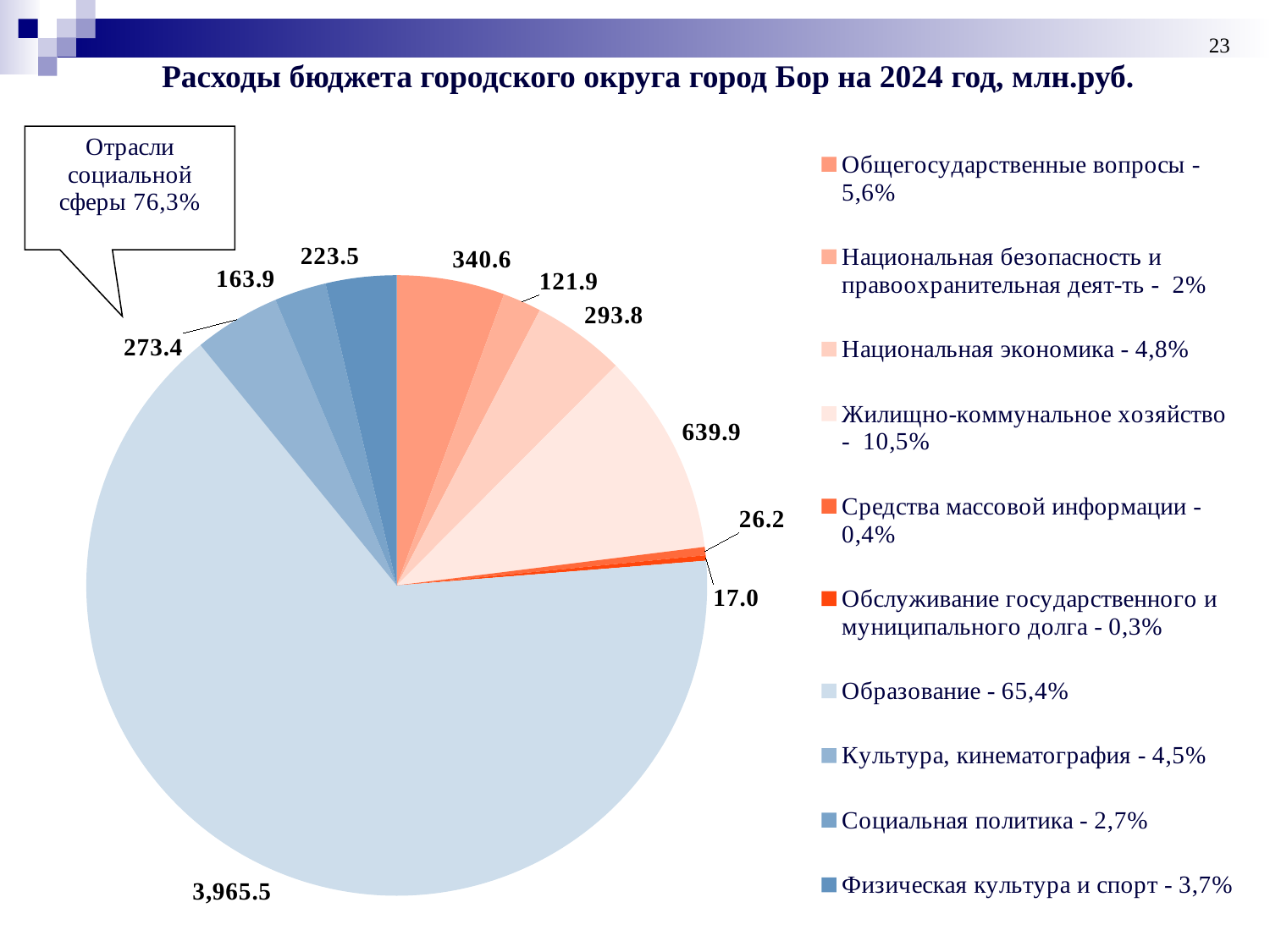
What is the value of the Жилищно-коммунальное хозяйство slice? 639.9 What is the value of the Общегосударственные вопросы slice? 340.6 What is the difference between the Культура, кинематография slice (273.4) and the Социальная политика slice (163.9)? 109.5 What type of chart is shown on the slide? pie chart Which category has the largest slice of the pie? Образование How many slices does the pie chart have? 10 Which category has the smallest slice of the pie? Обслуживание государственного и муниципального долга What share of the pie does Образование represent according to the legend? 65,4% Which is larger: the Физическая культура и спорт slice or the Национальная безопасность и правоохранительная деят-ть slice? Физическая культура и спорт What share is given in the callout for Отрасли социальной сферы? 76,3% What is the value of the Образование slice? 3,965.5 What is the title of the chart? Расходы бюджета городского округа город Бор на 2024 год, млн.руб.